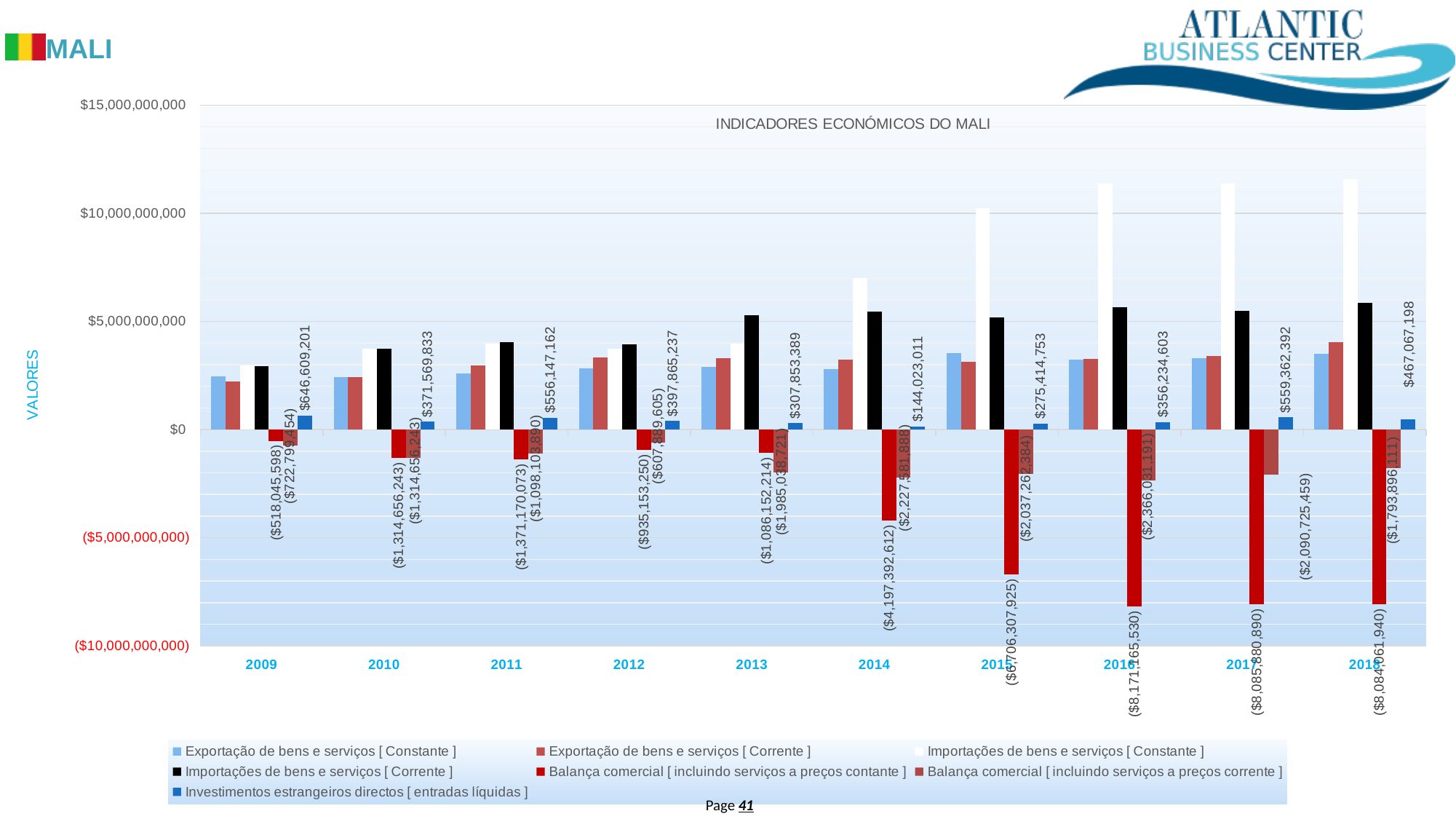
How many series does the legend list? 7 In which year is Investimentos estrangeiros directos [ entradas líquidas ] highest? 2009 What is the value of Investimentos estrangeiros directos [ entradas líquidas ] in 2009? $646,609,201 Which year has the larger value for Investimentos estrangeiros directos [ entradas líquidas ], 2017 or 2018? 2017 In which year is Investimentos estrangeiros directos [ entradas líquidas ] lowest? 2014 Is the value of Importações de bens e serviços [ Constante ] in 2018 greater or less than $10,000,000,000? greater What type of chart is shown on the slide? bar chart What is the value of Investimentos estrangeiros directos [ entradas líquidas ] in 2014? $144,023,011 What is the difference between Investimentos estrangeiros directos [ entradas líquidas ] in 2009 and in 2010? $275,039,368 What is the title of the chart? INDICADORES ECONÓMICOS DO MALI How many years are shown on the x axis? 10 What is the value of Balança comercial [ incluindo serviços a preços contante ] in 2015? ($6,706,307,925)